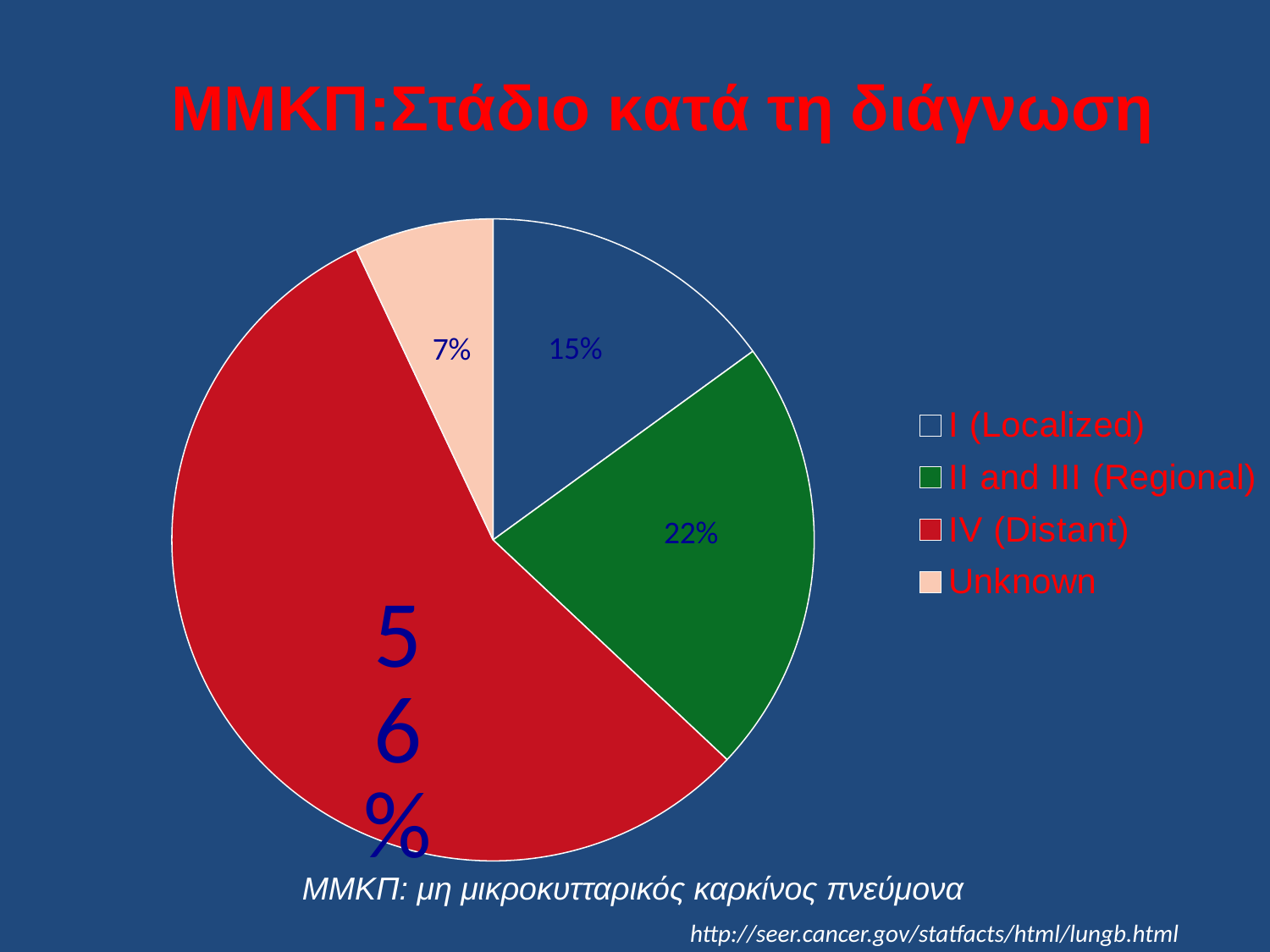
What colour is the slice for IV (Distant)? red Which category has the smallest slice of the pie? Unknown Which category has the largest slice of the pie? IV (Distant) What percentage of the pie is labelled for I (Localized)? 15% What percentage of the pie is labelled for Unknown? 7% What is the difference in percentage points between IV (Distant) and II and III (Regional)? 34 How many slices does the pie chart have? 4 How many entries does the legend list? 4 What kind of chart is shown on the slide? pie chart What percentage of the pie is labelled for IV (Distant)? 56% Which is larger, the slice for I (Localized) or the slice for II and III (Regional)? II and III (Regional) What percentage of the pie is labelled for II and III (Regional)? 22%